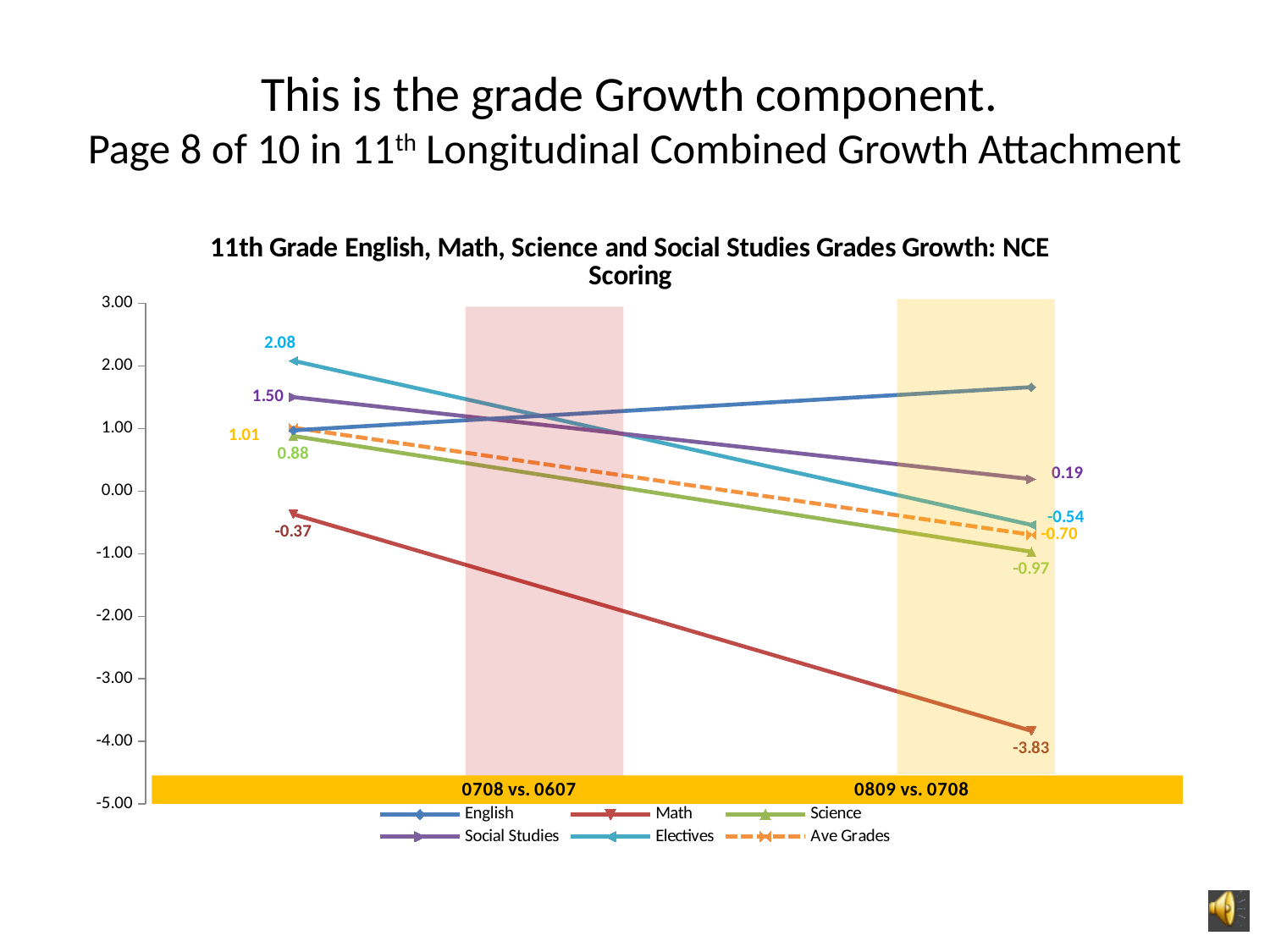
What is the value for Math at 0809 vs. 0708? -3.83 What kind of chart is shown on the slide? line chart What is the value for Social Studies at 0809 vs. 0708? 0.19 What is the difference between the Science values at 0708 vs. 0607 and 0809 vs. 0708? 1.85 How many series does the legend list? 6 Which series has the highest value at 0708 vs. 0607? Electives Does the Math line rise or fall from 0708 vs. 0607 to 0809 vs. 0708? fall Is the value for English at 0809 vs. 0708 greater or less than 1.00? greater What is the value for Ave Grades at 0708 vs. 0607? 1.01 What is the value for Electives at 0708 vs. 0607? 2.08 Which series has the lowest value at 0809 vs. 0708? Math How many categories are shown on the x axis? 2